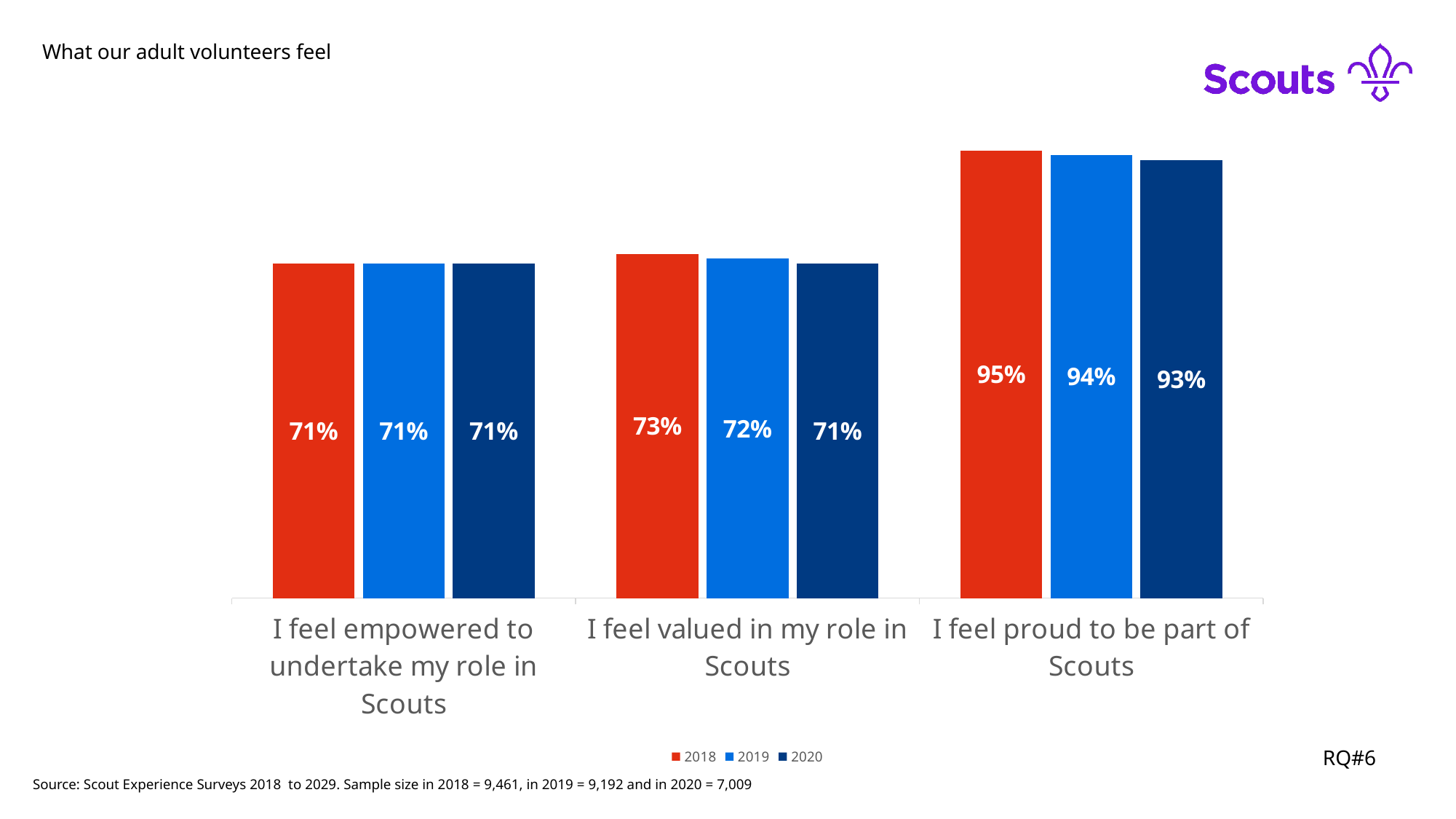
Do the values for "I feel proud to be part of Scouts" rise or fall from 2018 to 2020? Fall What is the difference between the 2018 and 2020 values for "I feel proud to be part of Scouts"? 2% What is the 2019 value for "I feel empowered to undertake my role in Scouts"? 71% What is the 2018 value for "I feel proud to be part of Scouts"? 95% Which statement has the highest value in 2020? I feel proud to be part of Scouts Which years are listed in the legend? 2018, 2019, 2020 How many series does the legend list? 3 How many statements (categories) are shown on the x axis? 3 What is the difference between the 2018 values for "I feel proud to be part of Scouts" and "I feel valued in my role in Scouts"? 22% Which is larger: the 2018 value for "I feel valued in my role in Scouts" or the 2018 value for "I feel empowered to undertake my role in Scouts"? I feel valued in my role in Scouts What is the 2020 value for "I feel valued in my role in Scouts"? 71% What kind of chart is shown on the slide? Bar chart